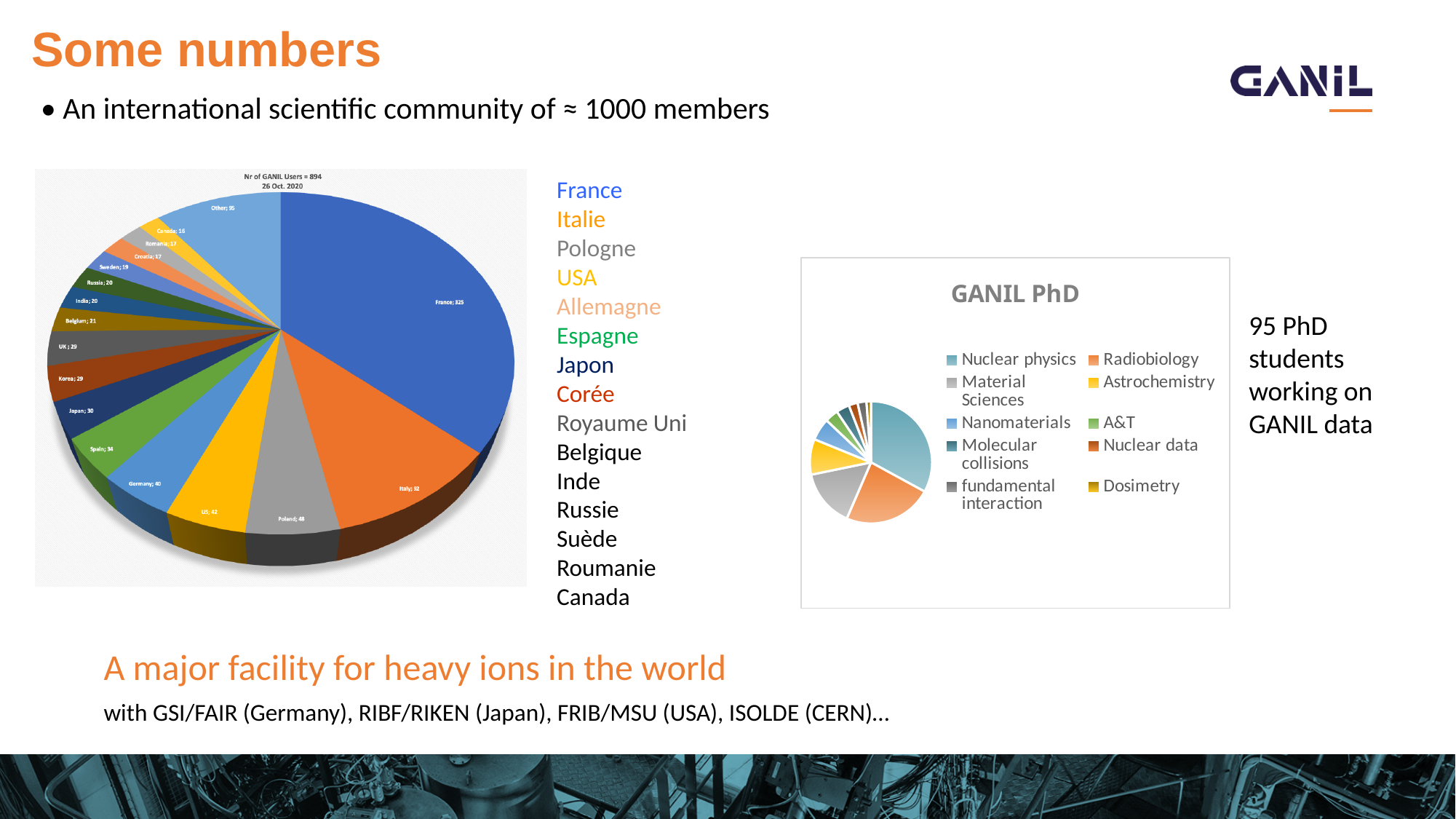
In the 'Nr of GANIL Users' pie chart on the left, what is the difference between the values for France and Italy? 233 What kind of chart is the 'GANIL PhD' chart on the right? Pie chart In the 'GANIL PhD' pie chart, which is larger, the Radiobiology slice or the Dosimetry slice? Radiobiology In the 'Nr of GANIL Users' pie chart on the left, what is the value for Poland? 48 In the 'Nr of GANIL Users' pie chart on the left, what is the value for Italy? 92 In the 'Nr of GANIL Users' pie chart on the left, which is larger, the value for US or the value for Germany? US In the 'Nr of GANIL Users' pie chart on the left, what total number of GANIL users is stated in the title? 894 In the 'Nr of GANIL Users' pie chart on the left, what is the value for Germany? 40 In the 'GANIL PhD' pie chart, which category has the largest slice? Nuclear physics In the 'Nr of GANIL Users' pie chart on the left, which country has the largest number of users? France How many categories does the legend of the 'GANIL PhD' pie chart list? 10 In the 'Nr of GANIL Users' pie chart on the left, what is the value for France? 325